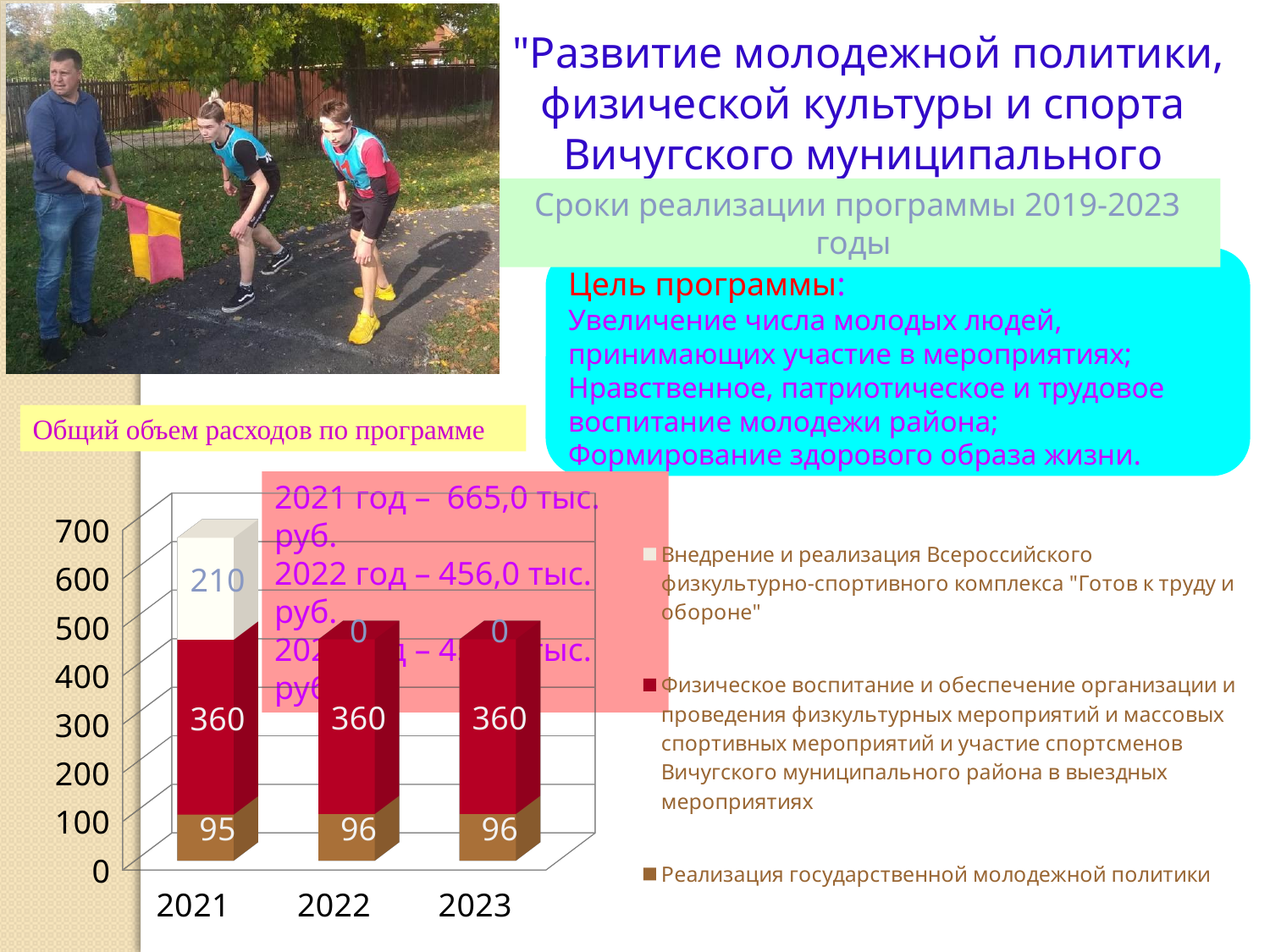
What kind of chart is shown on the slide? stacked bar chart What is the value of the "Готов к труду и обороне" series for 2021? 210 How many series does the chart legend list? 3 What is the value of the "Реализация государственной молодежной политики" series for 2021? 95 How many years are shown on the x axis of the chart? 3 What is the value of the "Физическое воспитание..." series for 2022? 360 Which year has the highest total stacked bar? 2021 What is the difference between the "Реализация государственной молодежной политики" values for 2022 and 2021? 1 What is the total of the stacked bar for 2022? 456 What is the total of the stacked bar for 2021? 665 What is the value of the "Реализация государственной молодежной политики" series for 2023? 96 What is the value of the "Готов к труду и обороне" series for 2022? 0